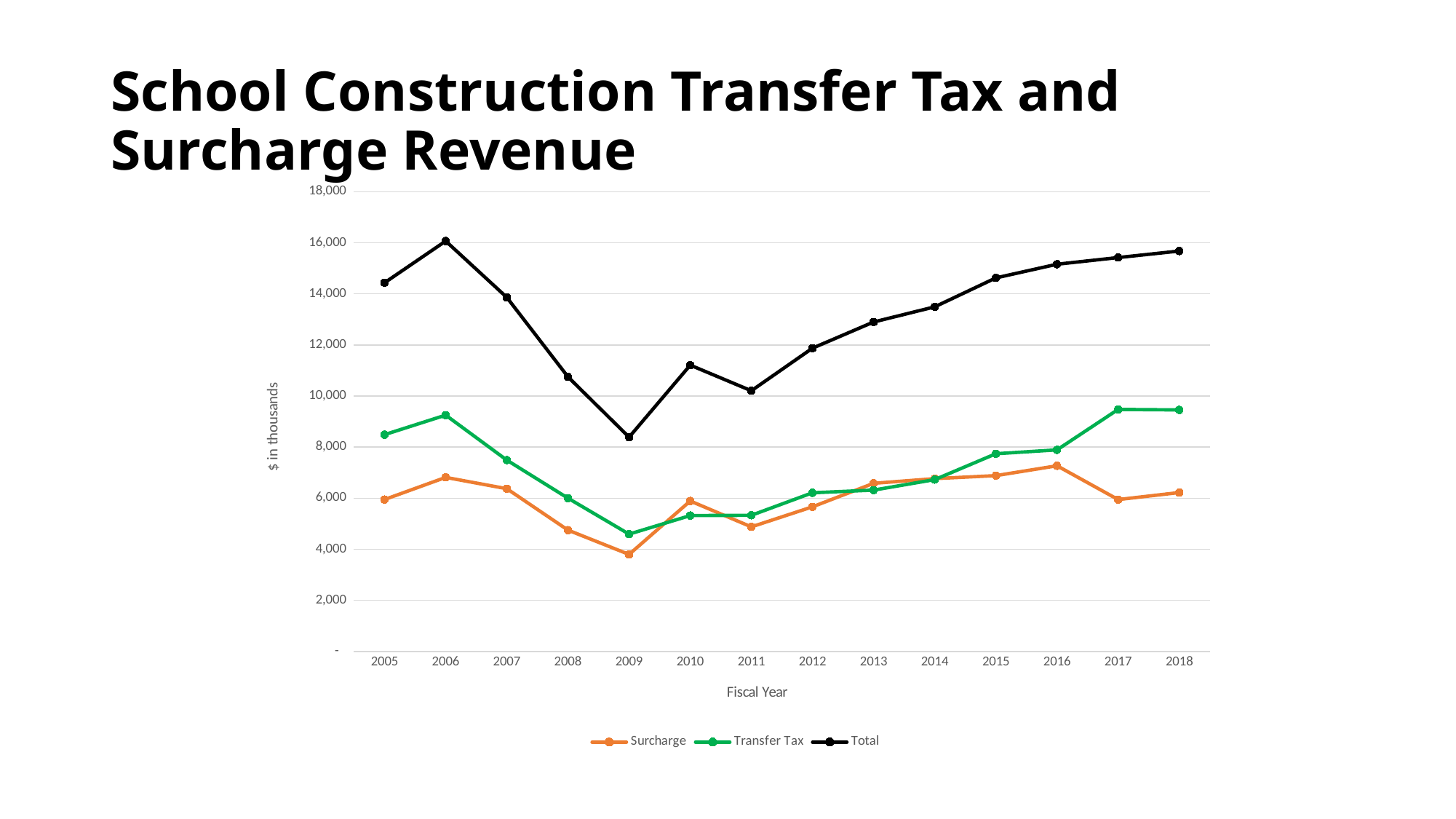
What is the label on the vertical axis? $ in thousands How many fiscal years are plotted on the x axis? 14 Is the Total value for 2009 greater or less than 10,000? less What kind of chart is shown on the slide? Line chart Does the Total series rise or fall from 2011 to 2018? rises In 2017, which is larger: Transfer Tax or Surcharge? Transfer Tax In which fiscal year is the Total series at its lowest? 2009 In which fiscal year is the Surcharge series at its lowest? 2009 Is the Transfer Tax value for 2018 greater or less than 8,000? greater How many series does the legend list? 3 Is the Surcharge value for 2016 greater or less than 6,000? greater In which fiscal year is the Total series at its highest? 2006